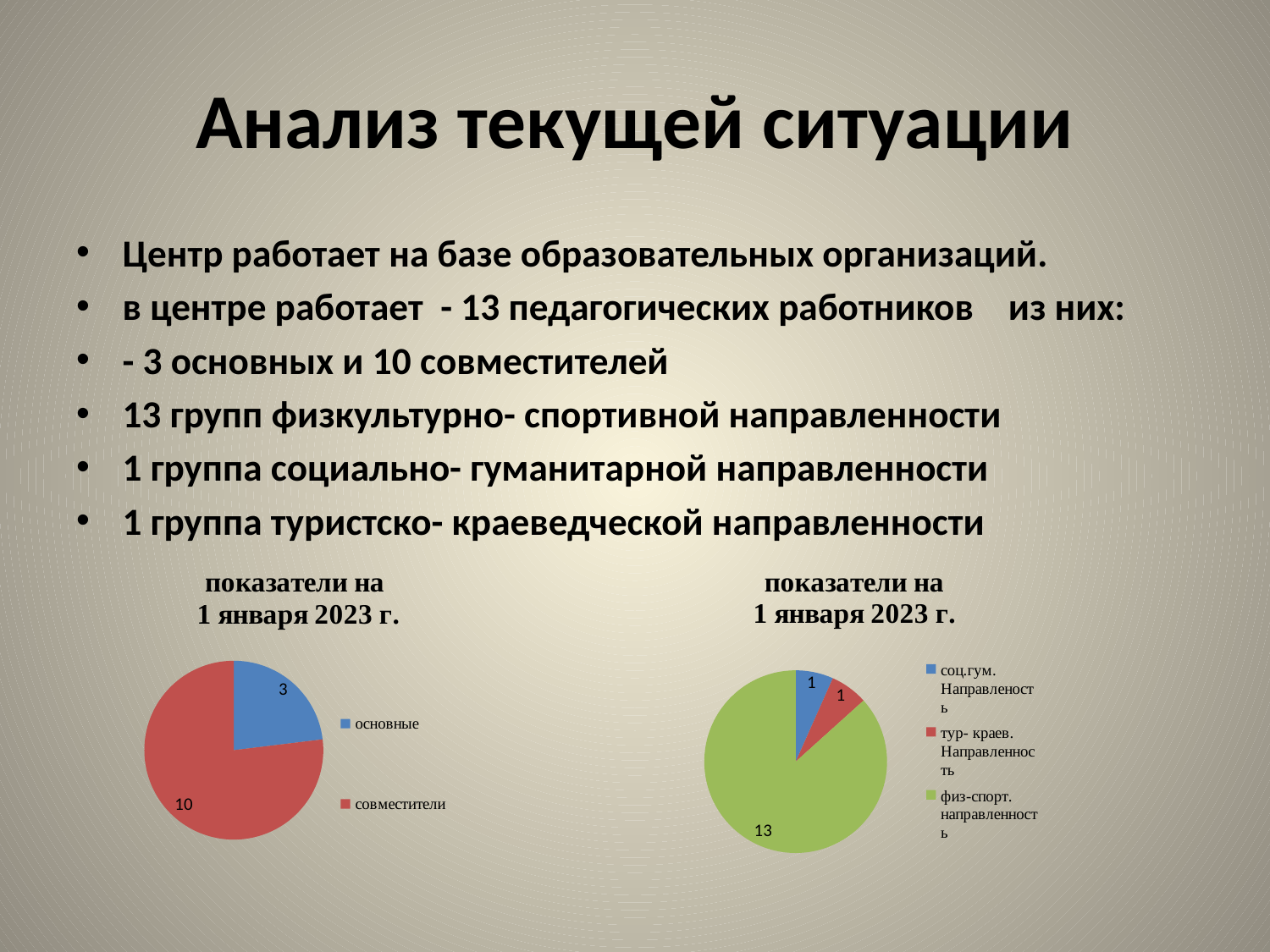
In the right pie chart, which category has the largest slice? физ-спорт. направленность In the left pie chart, what is the value for основные? 3 In the right pie chart, what is the value for физ-спорт. направленность? 13 In the left pie chart, which category has the largest slice? совместители In the left pie chart, how many categories does the legend list? 2 In the right pie chart, what is the value for соц.гум. Направленость? 1 What type of chart is the left chart on the slide? pie chart In the left pie chart, what is the difference between совместители and основные? 7 In the right pie chart, what is the total of all slices? 15 What is the title of the right pie chart? показатели на 1 января 2023 г. In the left pie chart, what is the value for совместители? 10 In the right pie chart, how many categories are shown? 3